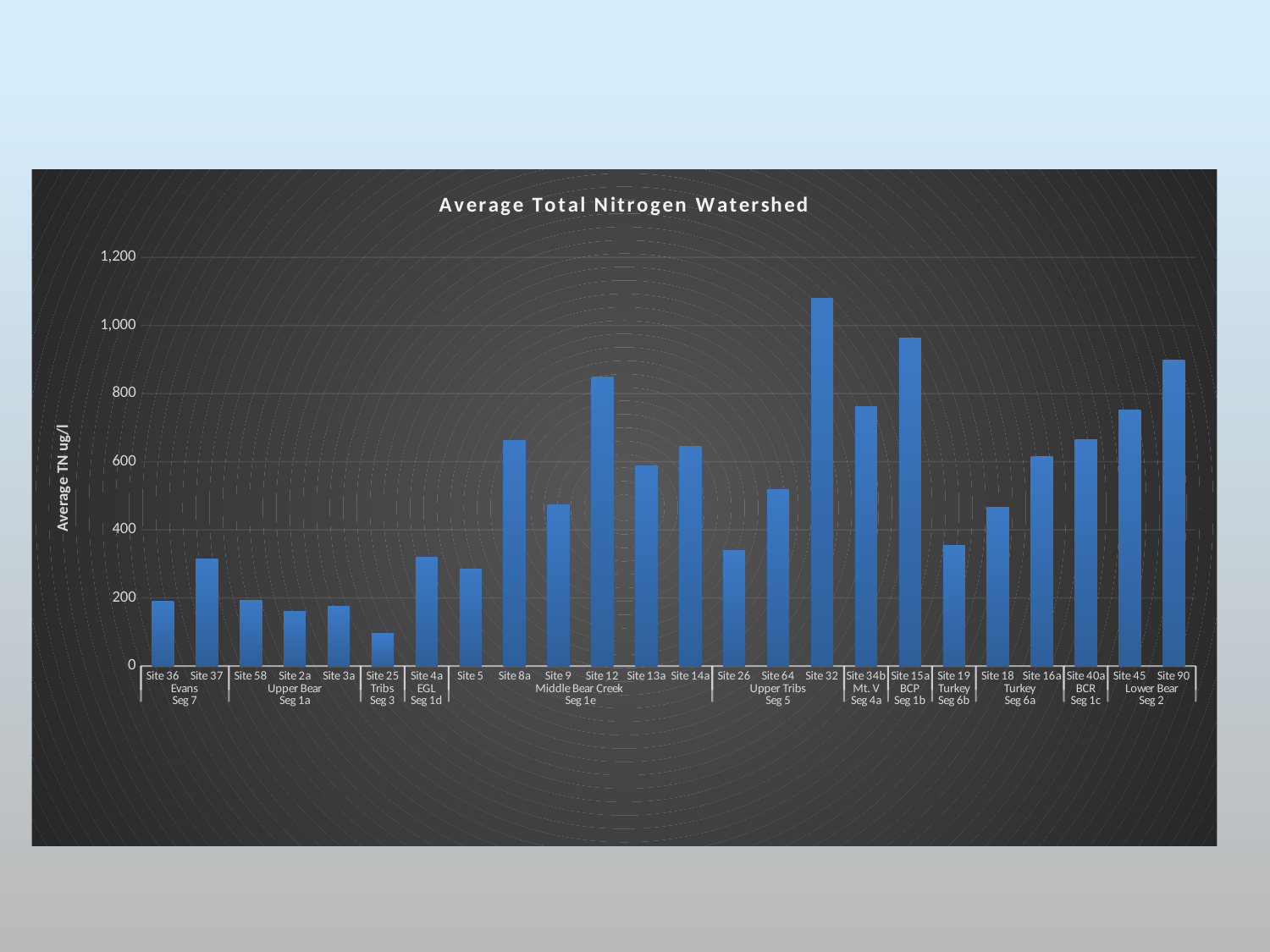
Is the value for Site 25 greater or less than 200? less Is the value for Site 12 greater or less than 800? greater Is the value for Site 32 greater or less than 1,000? greater Which site has the lowest average total nitrogen? Site 25 What type of chart is shown on the slide? bar chart What is the title of the chart? Average Total Nitrogen Watershed How many sites (bars) are plotted in the chart? 24 What is the label on the vertical axis of the chart? Average TN ug/l Which site has the highest average total nitrogen? Site 32 Which has a higher average total nitrogen, Site 36 or Site 37? Site 37 Which has a higher average total nitrogen, Site 12 or Site 13a? Site 12